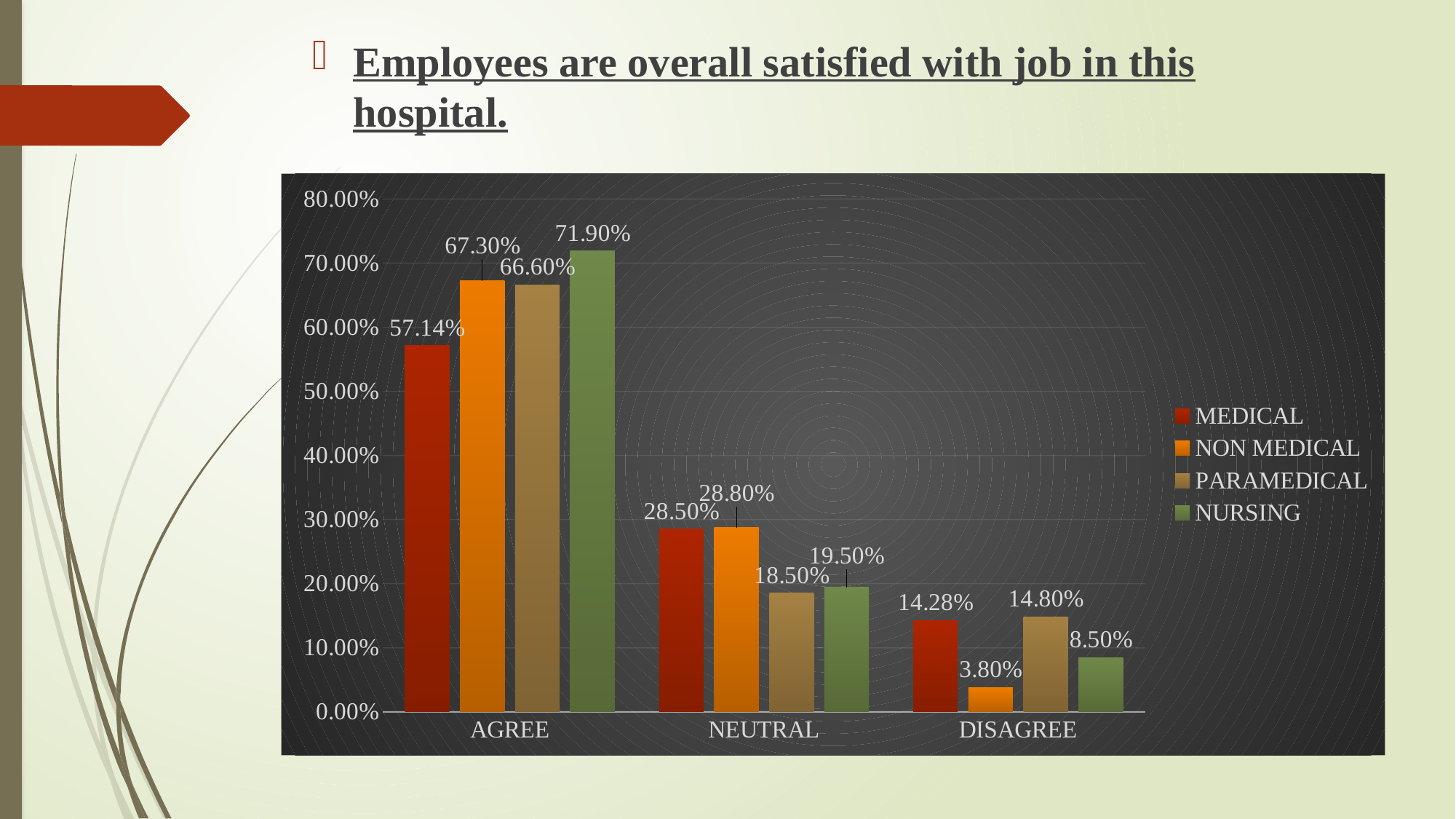
What kind of chart is shown on the slide? Bar chart Which series has the lowest value in the DISAGREE category? NON MEDICAL Which is larger in the NEUTRAL category: PARAMEDICAL or NURSING? NURSING Do the MEDICAL values rise or fall from AGREE to DISAGREE? Fall How many categories are shown on the x axis? 3 What percentage of NURSING employees agree? 71.90% What is the difference between the NURSING and MEDICAL values in the AGREE category? 14.76% Which series has the highest value in the AGREE category? NURSING What is the value for NON MEDICAL in the NEUTRAL category? 28.80% What is the value for MEDICAL in the DISAGREE category? 14.28% How many series does the legend list? 4 What colour represents the NON MEDICAL series in the legend? Orange